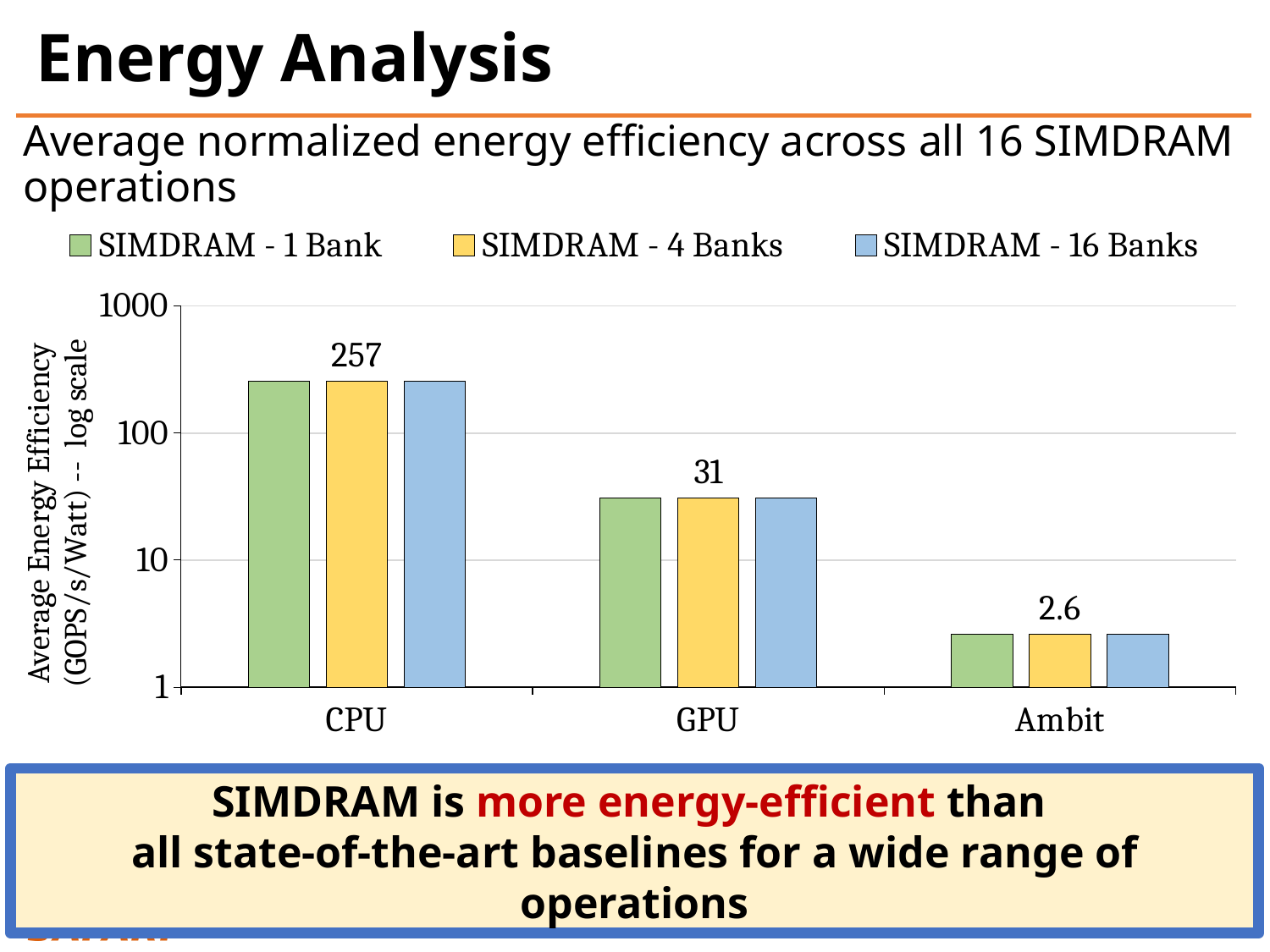
Is the value for SIMDRAM - 1 Bank in the GPU category greater or less than 100? less What kind of chart is shown on the slide? bar chart What is the labeled value for SIMDRAM - 4 Banks in the GPU category? 31 Which category has the lowest energy efficiency values? Ambit How many categories are shown on the x axis? 3 Is the labeled value for CPU larger or smaller than the labeled value for GPU? larger What is the labeled value for SIMDRAM - 4 Banks in the Ambit category? 2.6 What is the labeled value for SIMDRAM - 4 Banks in the CPU category? 257 How many series does the legend list? 3 What is the y-axis label of the chart? Average Energy Efficiency (GOPS/s/Watt) -- log scale Which category has the highest energy efficiency values? CPU Do the values rise or fall moving from CPU to Ambit along the x axis? fall